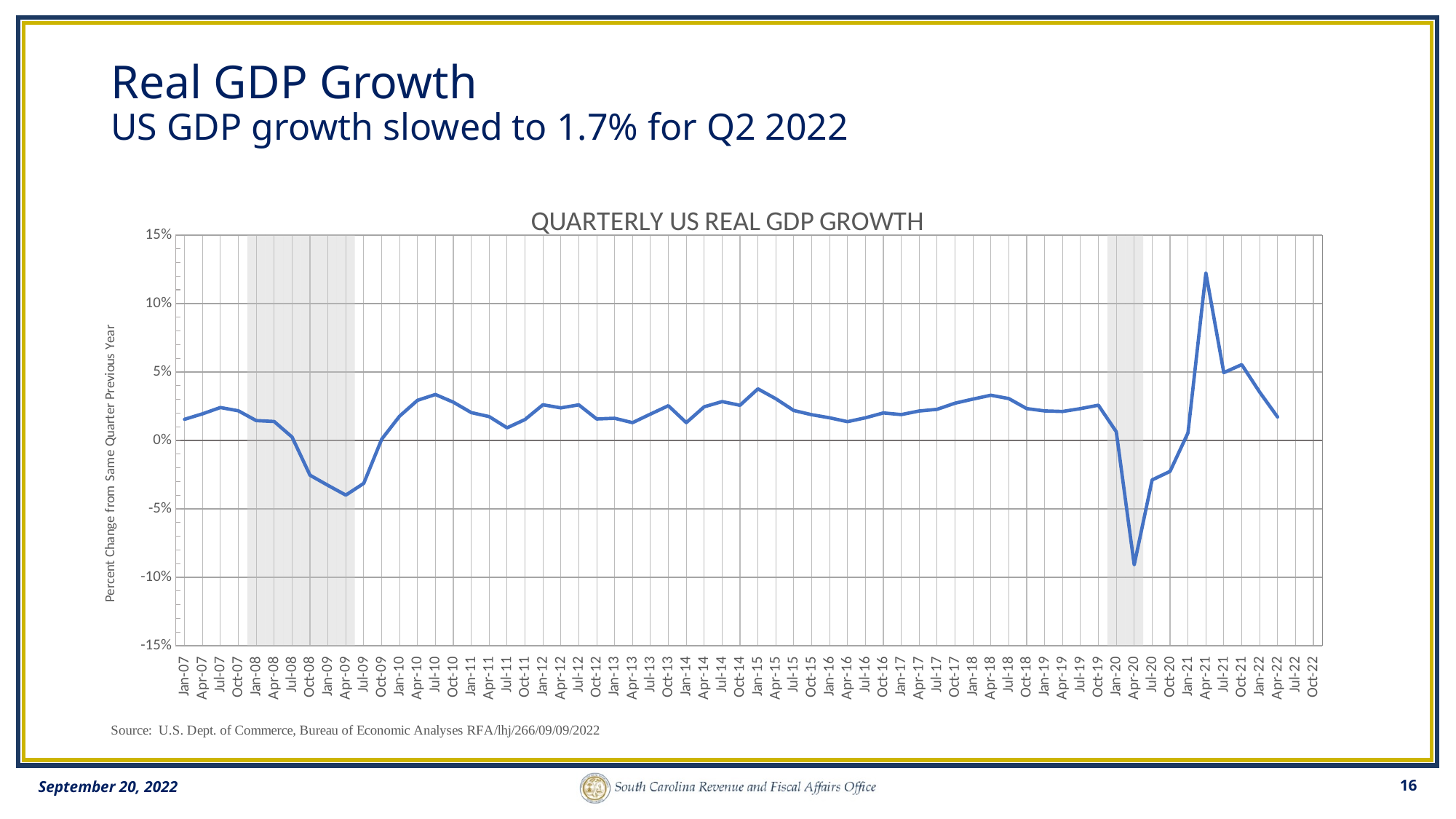
What is the title of the chart? QUARTERLY US REAL GDP GROWTH Is the value for Apr-21 greater or less than 10%? greater What is the label on the vertical axis of the chart? Percent Change from Same Quarter Previous Year Which is larger, the value for Apr-09 or the value for Apr-20? Apr-09 Which quarter has the lowest real GDP growth on the chart? Apr-20 What kind of chart is shown on the slide? line chart Is the value for Apr-09 greater or less than 0%? less Do the values rise or fall from Apr-21 to Apr-22? fall Is the value for Apr-20 greater or less than -5%? less Which is larger, the value for Apr-21 or the value for Jan-15? Apr-21 Which quarter has the highest real GDP growth on the chart? Apr-21